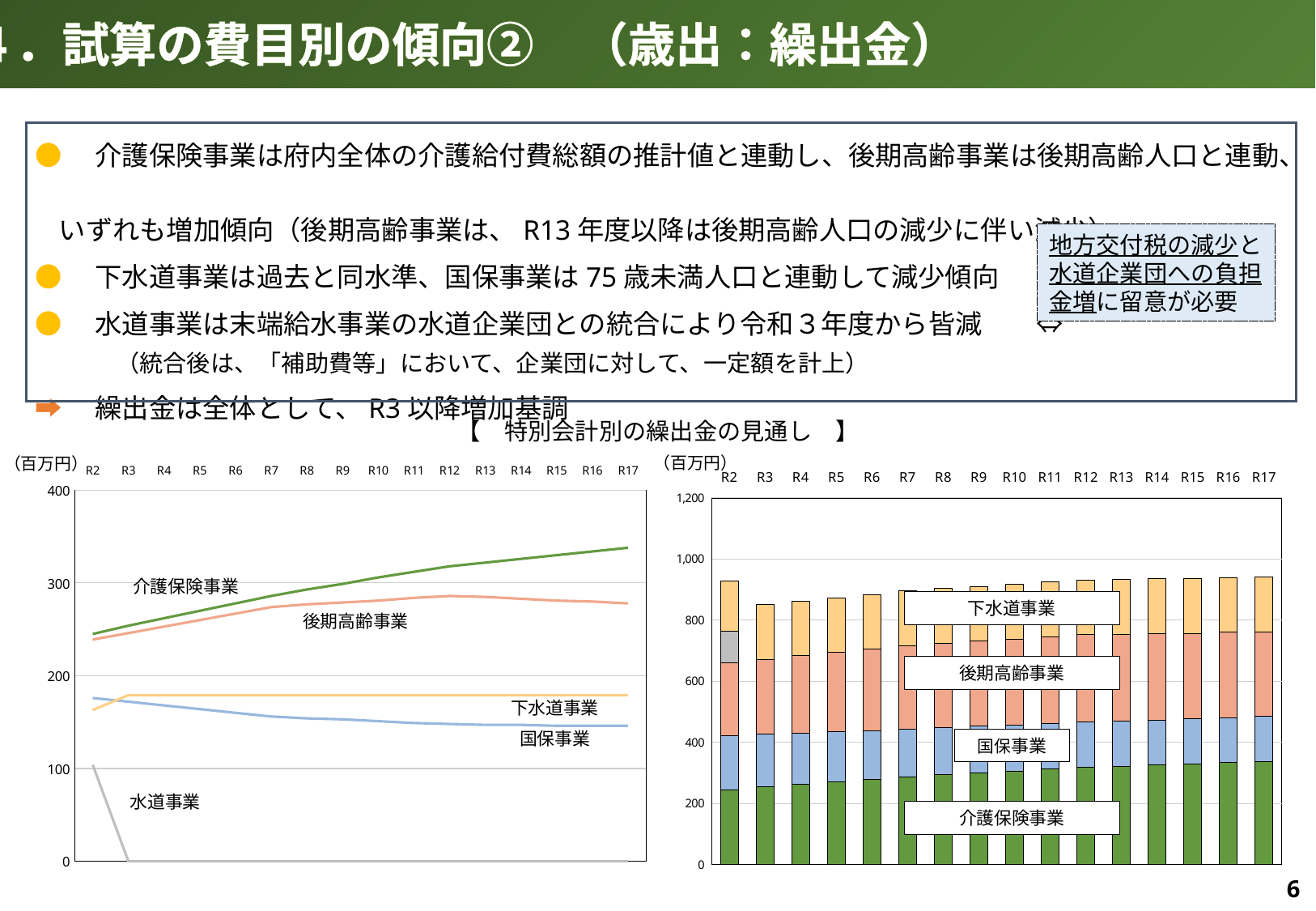
In the right chart, which series forms the bottom segment of each stacked bar? 介護保険事業 In the right chart, is the total height of the R17 bar greater or less than 800? greater In the left chart, which series has the highest value at R17? 介護保険事業 In the left chart, how many fiscal years are shown along the x axis? 16 In the left chart, at R17, which is larger: 下水道事業 or 国保事業? 下水道事業 In the left chart, what is the value for 水道事業 at R10? 0 What kind of chart is the chart on the left side of the slide? line chart What kind of chart is the chart on the right side of the slide? stacked bar chart In the left chart, does the 国保事業 line rise or fall from R2 to R17? fall In the left chart, is the value for 介護保険事業 at R17 greater or less than 300? greater In the left chart, how many series are labelled on the plot? 5 In the left chart, does the 介護保険事業 line rise or fall from R2 to R17? rise